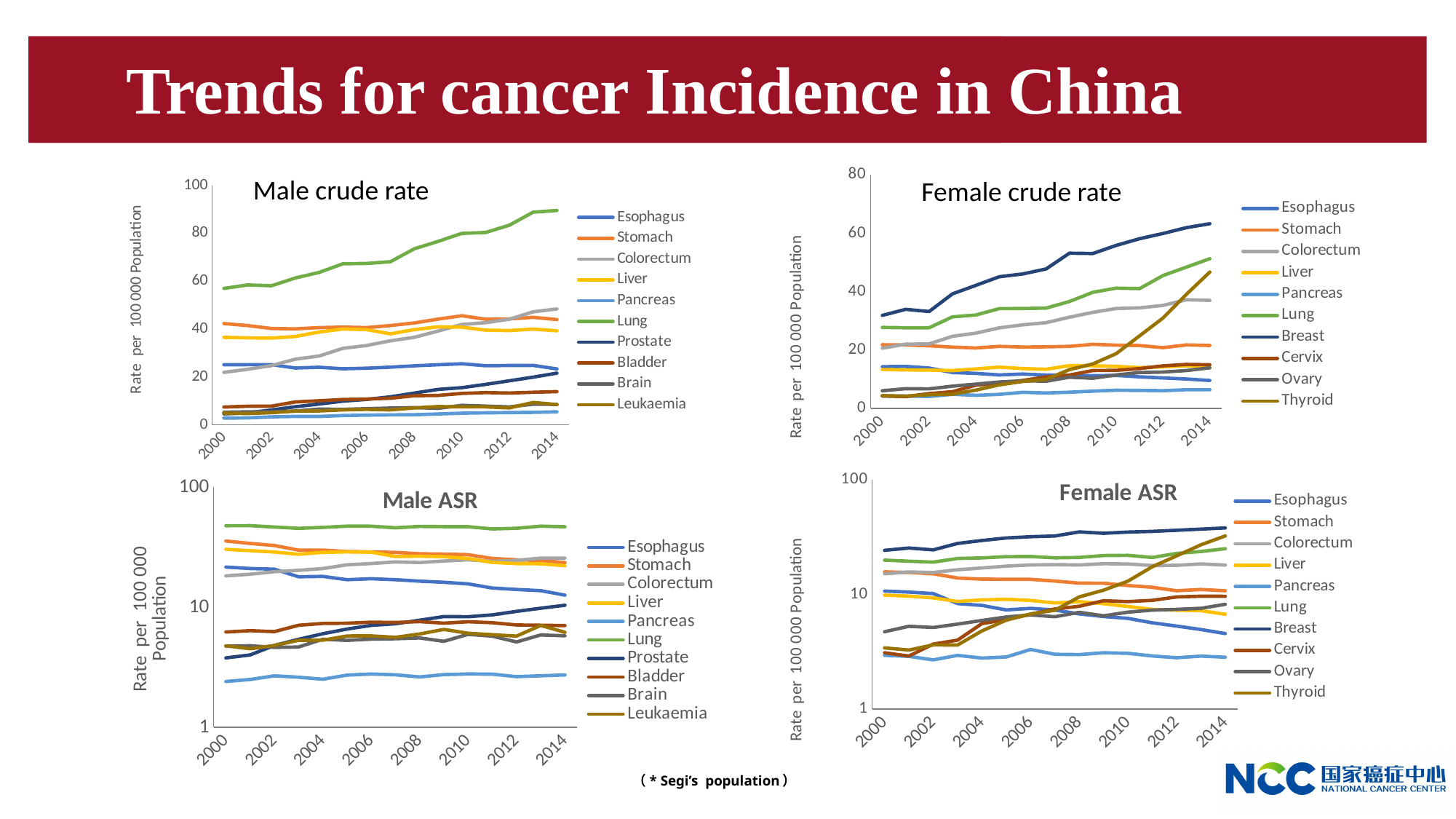
How many series does the legend of the "Female crude rate" chart list? 10 In the "Female crude rate" chart, is the Breast rate in 2014 greater or less than 60? greater How many charts are shown on the slide? 4 In the "Male crude rate" chart, which cancer site has the highest rate in 2014? Lung In the "Male crude rate" chart, does the Lung rate rise or fall from 2000 to 2014? rise In the "Male crude rate" chart, which cancer site has the lowest rate in 2000? Pancreas What type of chart is the "Male crude rate" chart? line chart In the "Female crude rate" chart, does the Thyroid rate rise or fall from 2000 to 2014? rise In the "Female crude rate" chart, which cancer site has the highest rate in 2014? Breast In the "Male ASR" chart, does the Esophagus rate rise or fall from 2000 to 2014? fall In the "Female ASR" chart, which is larger in 2014, the Breast rate or the Stomach rate? Breast In the "Male crude rate" chart, is the Lung rate in 2014 greater or less than 80? greater